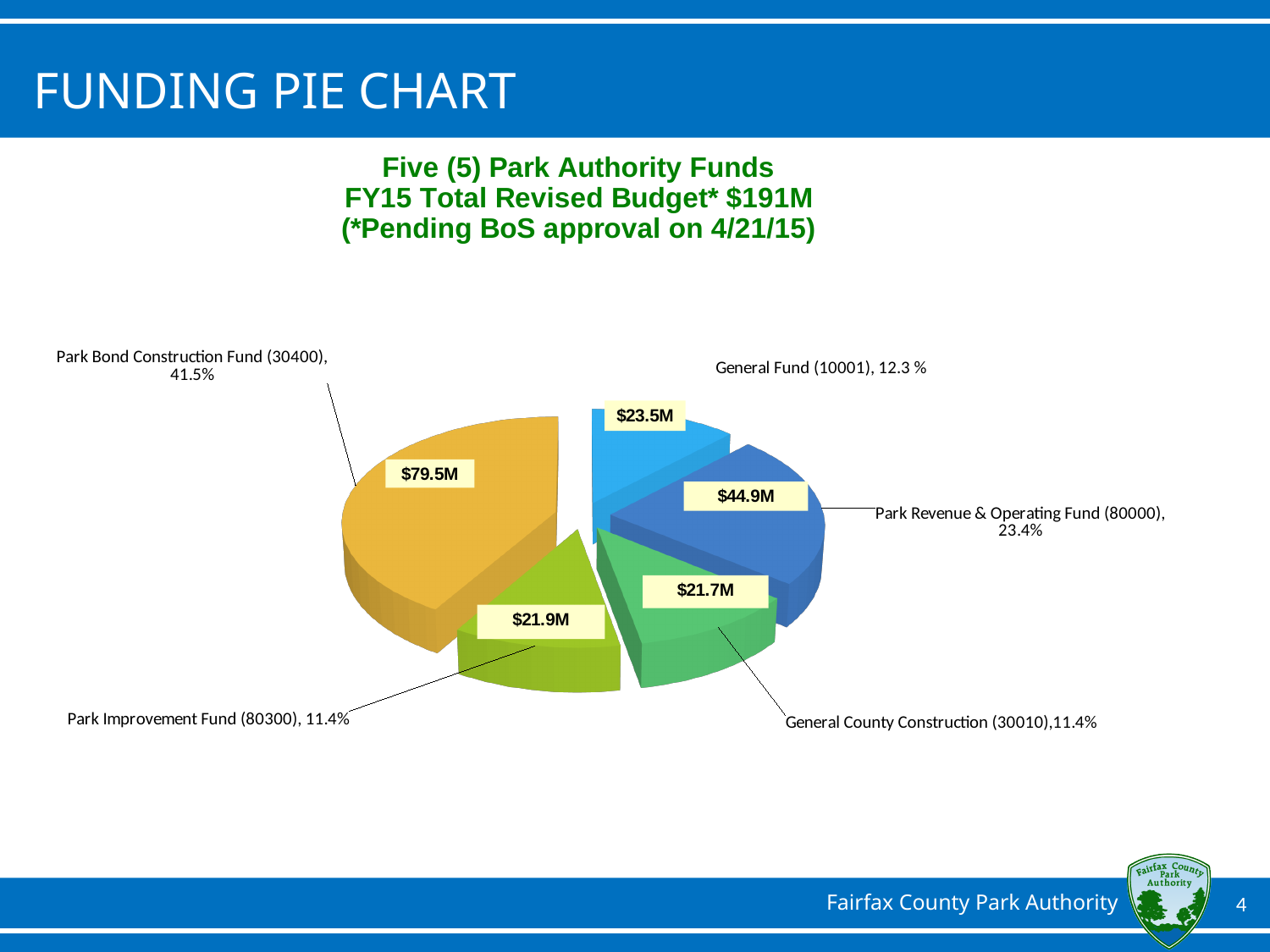
What is the FY15 Total Revised Budget stated above the pie chart? $191M What is the difference between the Park Bond Construction Fund value and the Park Revenue & Operating Fund value? $34.6M What is the value shown for General County Construction (30010)? $21.7M How many funds (slices) are shown in the pie chart? 5 What is the value shown for the Park Bond Construction Fund (30400)? $79.5M What share of the pie does the Park Bond Construction Fund (30400) represent? 41.5% Which fund has the smallest value in the pie chart? General County Construction (30010) What is the value shown for the Park Revenue & Operating Fund (80000)? $44.9M What kind of chart is shown on the slide? Pie chart What share of the pie does the Park Revenue & Operating Fund (80000) represent? 23.4% Which fund has the largest slice of the pie? Park Bond Construction Fund (30400) What is the value shown for the General Fund (10001)? $23.5M